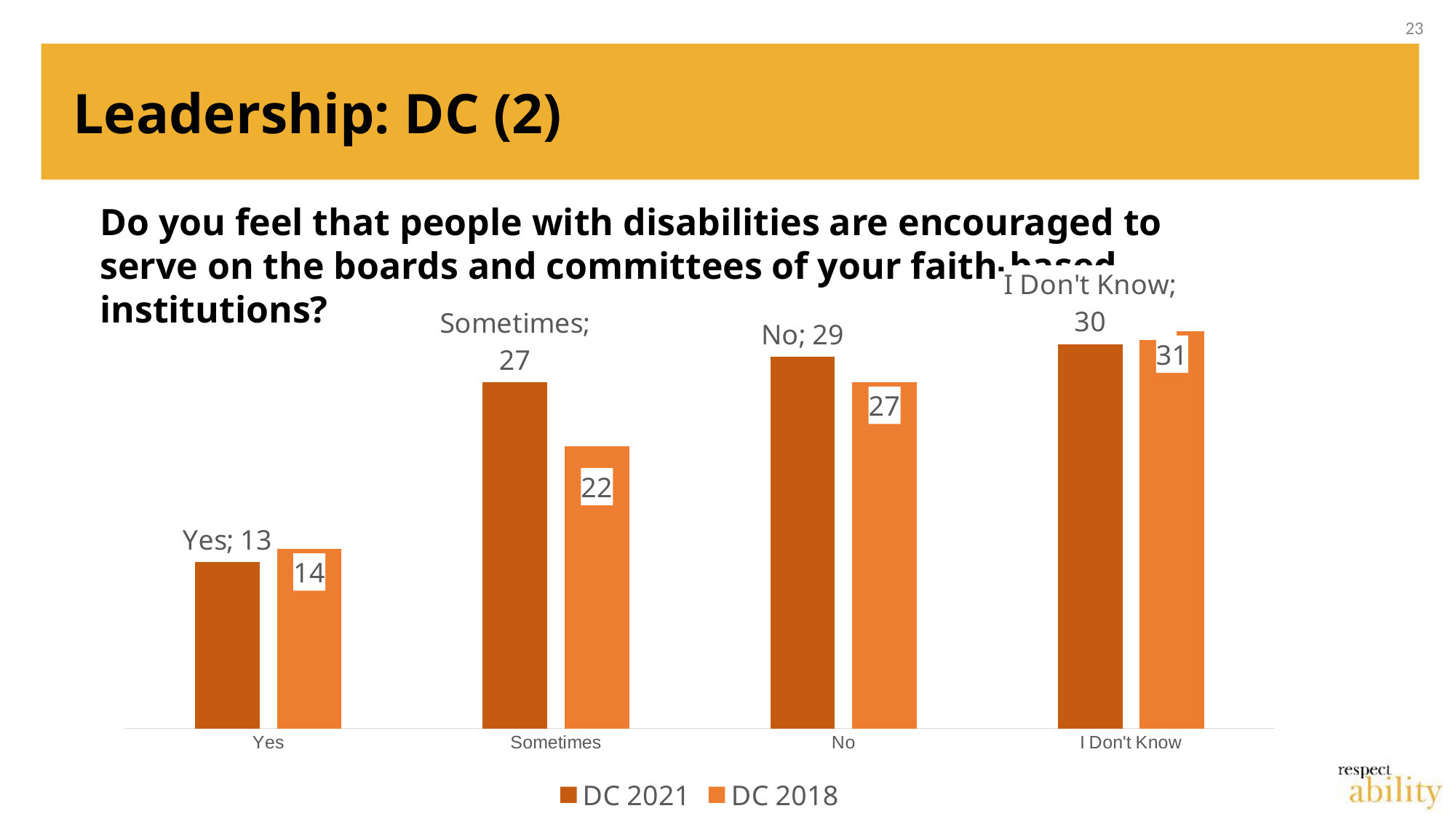
Which category has the lowest DC 2021 value? Yes What kind of chart is shown on the slide? Bar chart Which is larger for No: the DC 2021 value or the DC 2018 value? DC 2021 Which category has the highest DC 2018 value? I Don't Know How many categories are shown on the x axis? 4 What is the DC 2021 value for I Don't Know? 30 What is the DC 2018 value for Yes? 14 What are the two series named in the legend? DC 2021 and DC 2018 What is the DC 2018 value for No? 27 What is the DC 2021 value for Sometimes? 27 How many series does the legend list? 2 What is the difference between the DC 2021 and DC 2018 values for Sometimes? 5